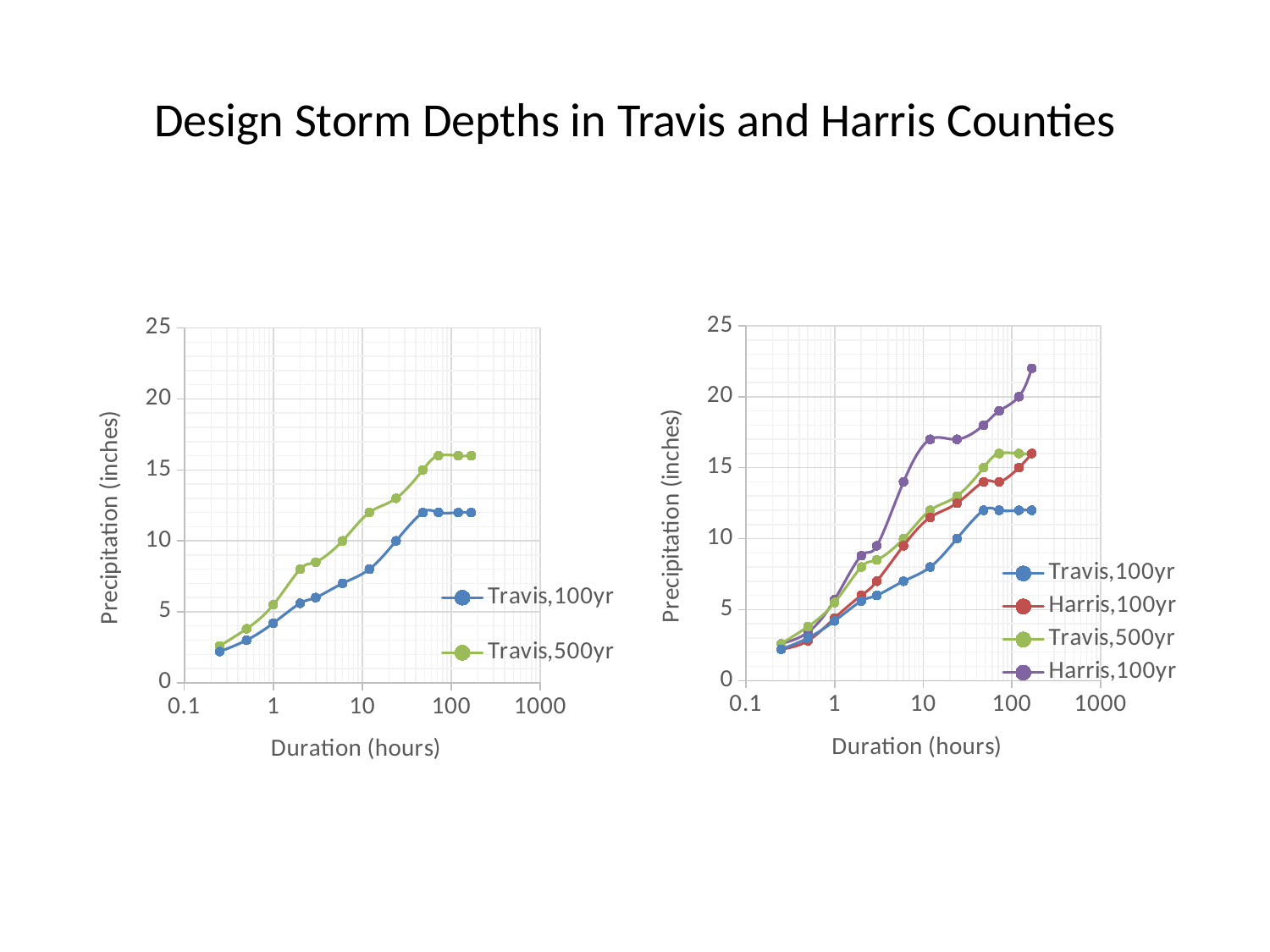
What is the label of the y axis on the left chart? Precipitation (inches) What is the label of the x axis on both charts? Duration (hours) In the left chart, is the value for Travis,100yr at 1 hour greater or less than 5? less In the left chart, which series is higher at 10 hours, Travis,100yr or Travis,500yr? Travis,500yr In the left chart, is the value for Travis,500yr at 100 hours greater or less than 15? greater What kind of chart is the left chart on the slide? line chart In the right chart, which series is higher at 10 hours, the purple Harris series or Travis,500yr? the purple Harris series How many series does the legend of the right chart list? 4 In the right chart, is the highest value of the purple Harris series greater or less than 20? greater How many series does the legend of the left chart list? 2 In the left chart, do the Travis,500yr values rise or fall as duration increases? rise In the right chart, which series reaches the highest precipitation value? the purple Harris series